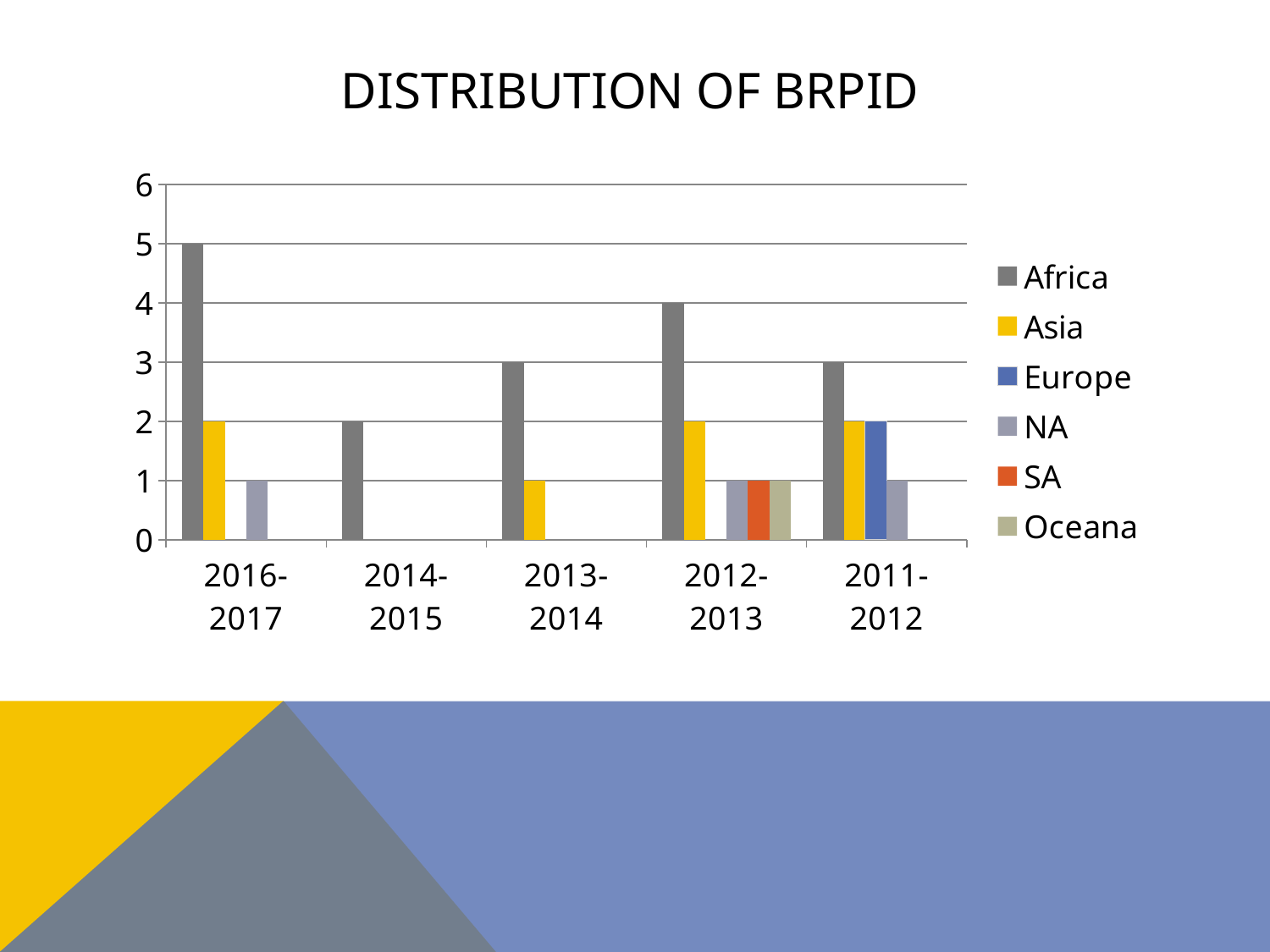
How many series does the legend list? 6 What is the difference between the Africa value in 2016-2017 and the Africa value in 2014-2015? 3 What is the value for Asia in 2012-2013? 2 Which is larger in 2012-2013, the value for Africa or the value for Asia? Africa What is the value for Europe in 2011-2012? 2 In which year category is the Africa value lowest? 2014-2015 Which series is shown in yellow in the legend? Asia What is the title of the chart? DISTRIBUTION OF BRPID What is the value for Africa in 2016-2017? 5 How many year categories are shown on the x axis? 5 In which year category is the Africa value highest? 2016-2017 What type of chart is shown on the slide? bar chart